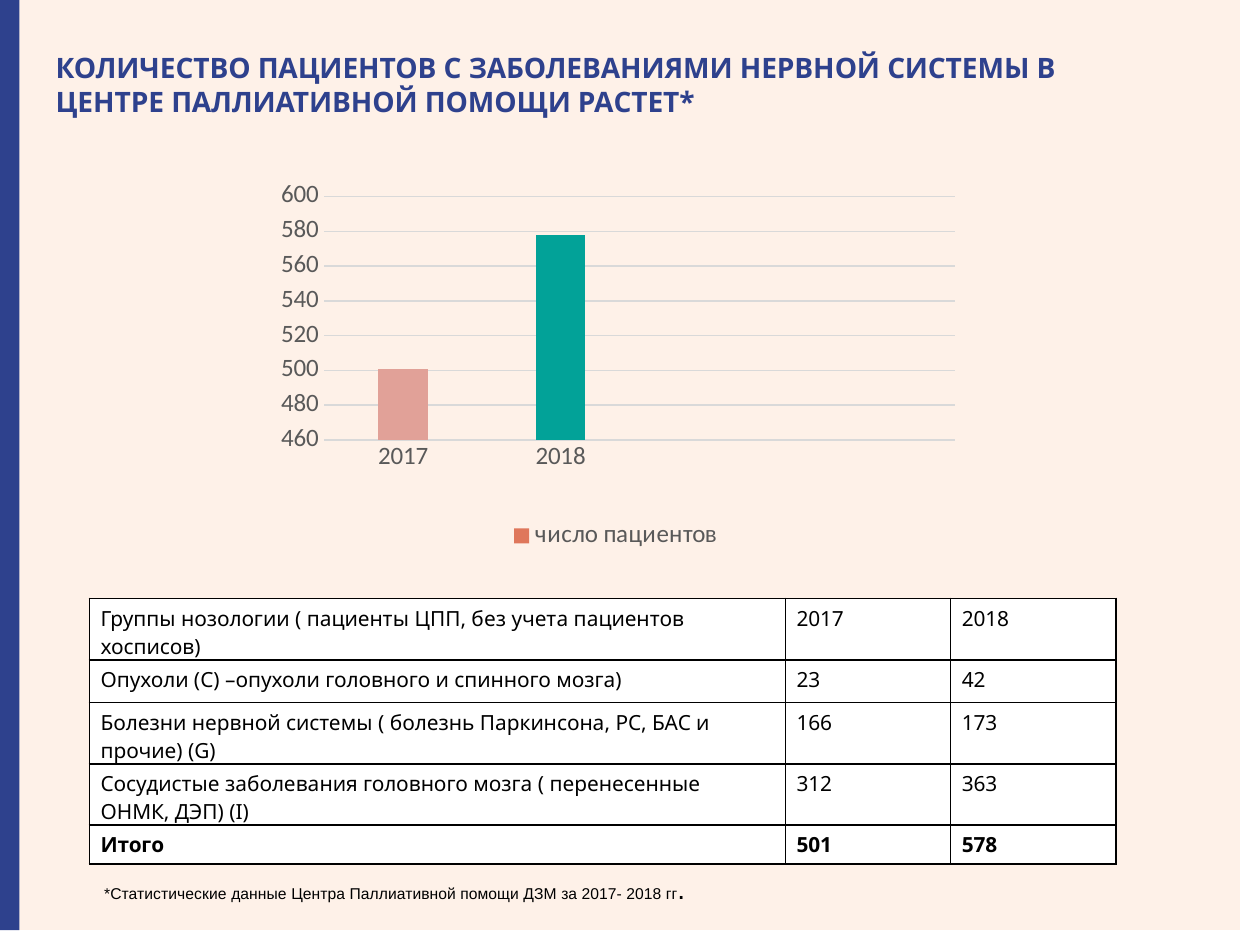
Which year has the higher number of patients on the chart? 2018 Is the value for 2017 greater or less than 520? less What kind of chart is shown on the slide? bar chart How many series does the chart legend list? 1 Is the value for 2018 greater or less than 560? greater What is the number of patients for 2018, as given in the Итого row of the table? 578 How many years (categories) are plotted on the chart? 2 What is the legend entry shown below the chart? число пациентов What is the number of patients for 2017, as given in the Итого row of the table? 501 Do the values rise or fall from 2017 to 2018? rise Which year has the lower number of patients on the chart? 2017 Is the bar for 2018 taller or shorter than the bar for 2017? taller